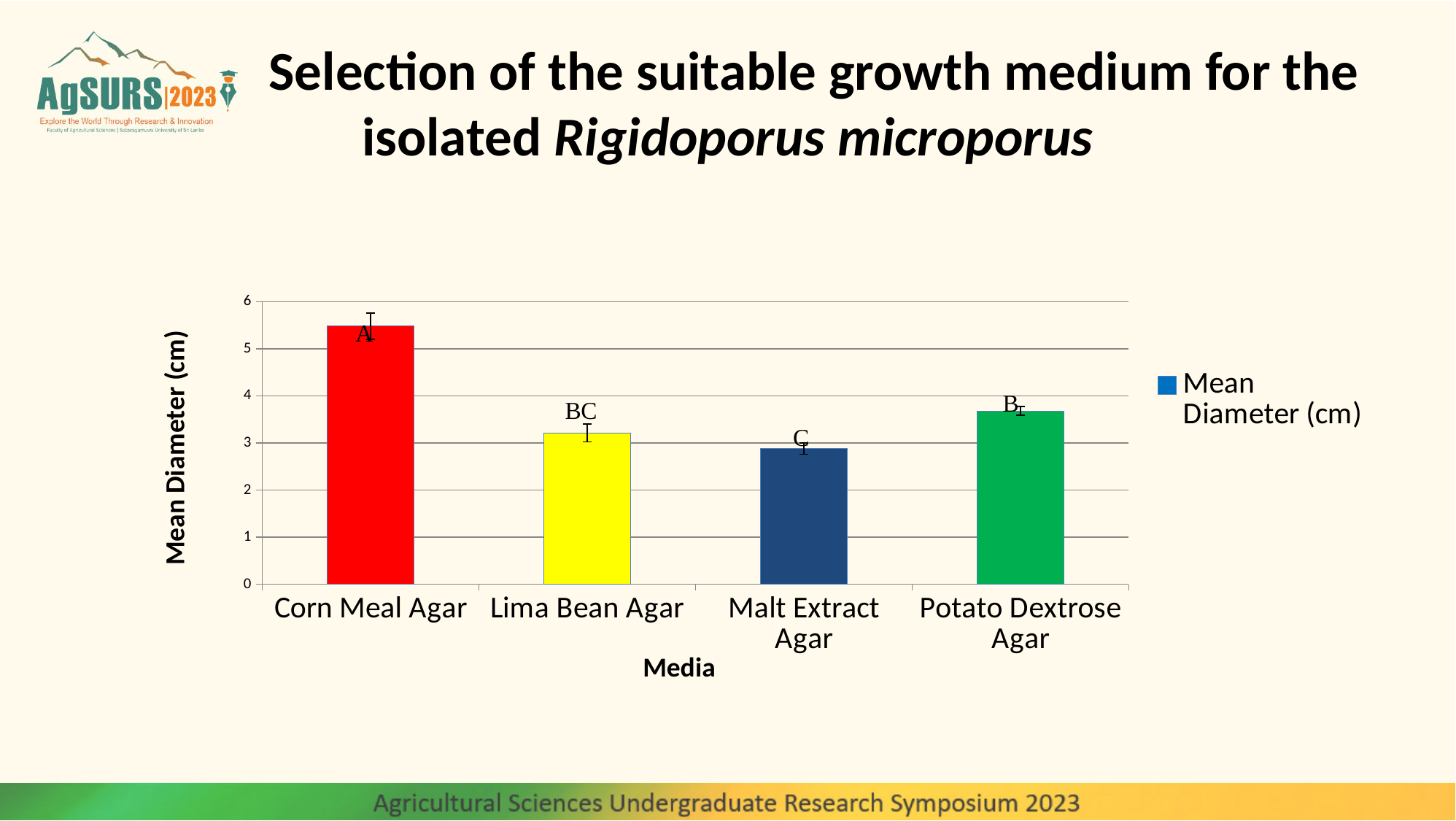
What is the label on the y axis of the chart? Mean Diameter (cm) Is the mean diameter for Lima Bean Agar greater or less than 3? greater How many series does the legend list? 1 Which medium has the highest mean diameter? Corn Meal Agar Is the mean diameter for Potato Dextrose Agar greater or less than 4? less How many media (categories) are plotted on the x axis? 4 Which medium has the lowest mean diameter? Malt Extract Agar Which has a larger mean diameter, Potato Dextrose Agar or Lima Bean Agar? Potato Dextrose Agar What kind of chart is shown on the slide? bar chart What letter label is shown above the Lima Bean Agar bar? BC Is the mean diameter for Corn Meal Agar greater or less than 5? greater